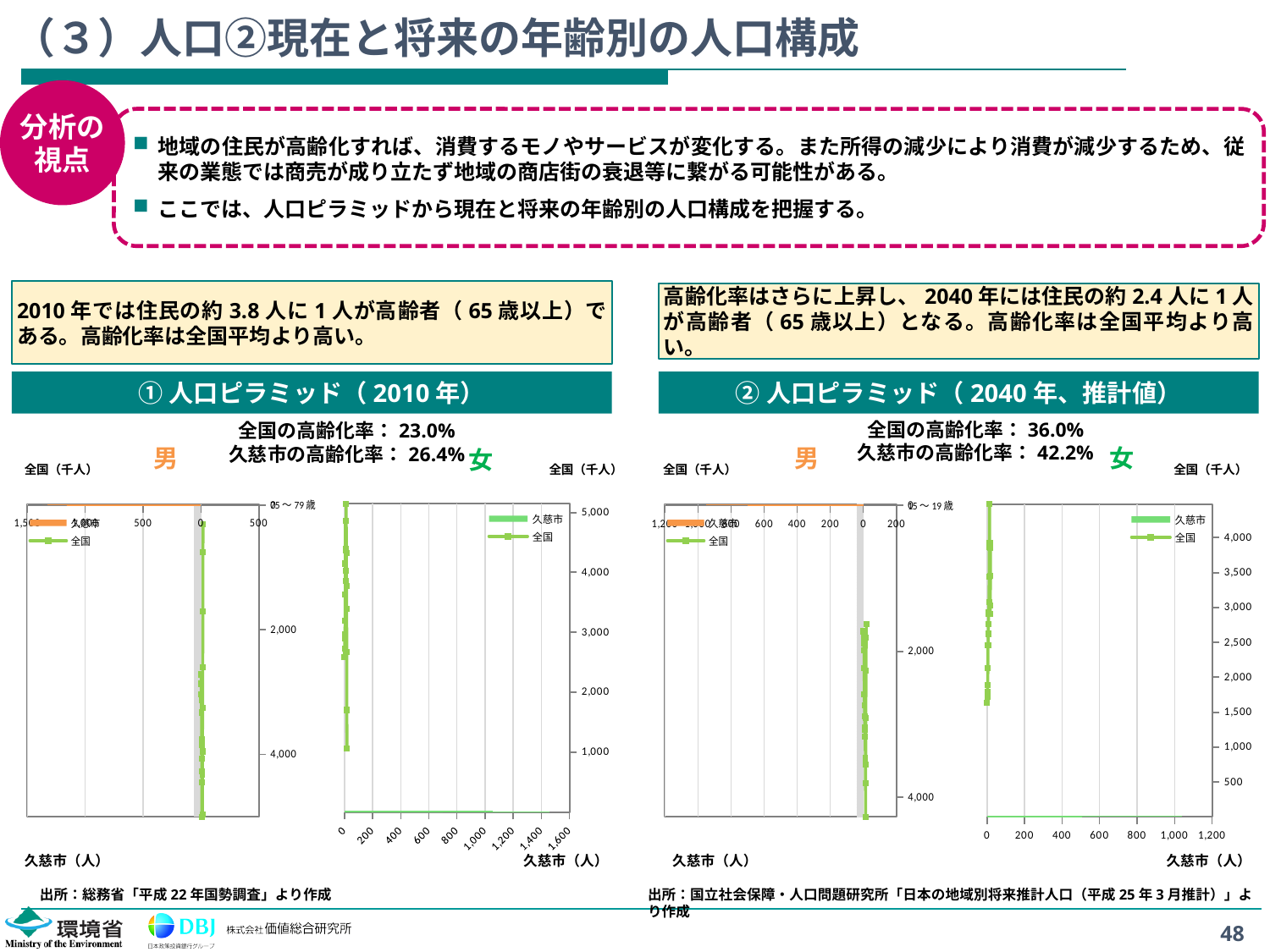
On the ② 人口ピラミッド（2040年、推計値） chart, what is the aging rate for 久慈市 shown? 42.2% On the ① 人口ピラミッド（2010年） chart, by how many percentage points does the 久慈市 aging rate exceed the national aging rate? 3.4 percentage points On the ② 人口ピラミッド（2040年、推計値） chart, by how many percentage points does the 久慈市 aging rate exceed the national aging rate? 6.2 percentage points How many series does the legend of the ① 人口ピラミッド（2010年） chart list? 2 On the ① 人口ピラミッド（2010年） chart, which is higher, the aging rate for 久慈市 or for 全国? 久慈市 Which chart on the slide shows estimated values (推計値)? ② 人口ピラミッド（2040年、推計値） What are the two legend entries on the ② 人口ピラミッド（2040年、推計値） chart? 久慈市 and 全国 On the ① 人口ピラミッド（2010年） chart, what is the national aging rate (全国の高齢化率) shown? 23.0% On the ② 人口ピラミッド（2040年、推計値） chart, what is the national aging rate (全国の高齢化率) shown? 36.0% On the ① 人口ピラミッド（2010年） chart, what is the aging rate for 久慈市 shown? 26.4% On the ② 人口ピラミッド（2040年、推計値） chart, which is higher, the aging rate for 久慈市 or for 全国? 久慈市